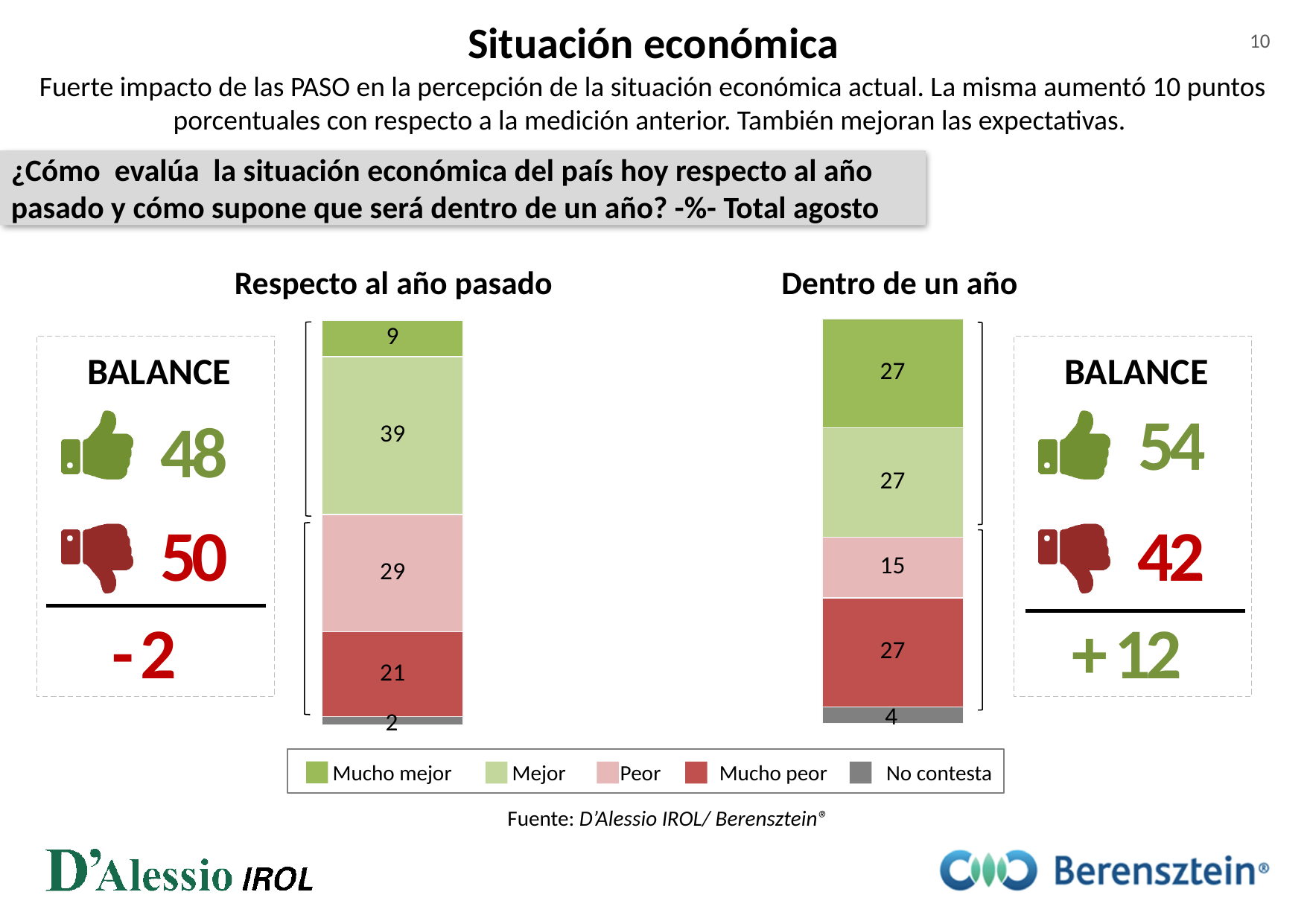
In the 'Dentro de un año' chart, which category has the lowest value? No contesta How many series does the legend list? 5 In the 'Dentro de un año' chart, which is larger, 'Mejor' or 'Peor'? Mejor In the 'Respecto al año pasado' chart, what is the total of the 'Mucho mejor' and 'Mejor' segments? 48 In the 'Dentro de un año' chart, what is the value for 'Mucho mejor'? 27 In the 'Dentro de un año' chart, what is the value for 'Peor'? 15 In the 'Respecto al año pasado' chart, which category has the highest value? Mejor In the 'Respecto al año pasado' chart, what is the value for 'Mejor'? 39 What kind of chart is used on this slide? Stacked bar chart Which legend entry is shown in grey? No contesta In the 'Respecto al año pasado' chart, what is the value for 'No contesta'? 2 In the 'Respecto al año pasado' chart, what is the difference between 'Peor' and 'Mucho peor'? 8